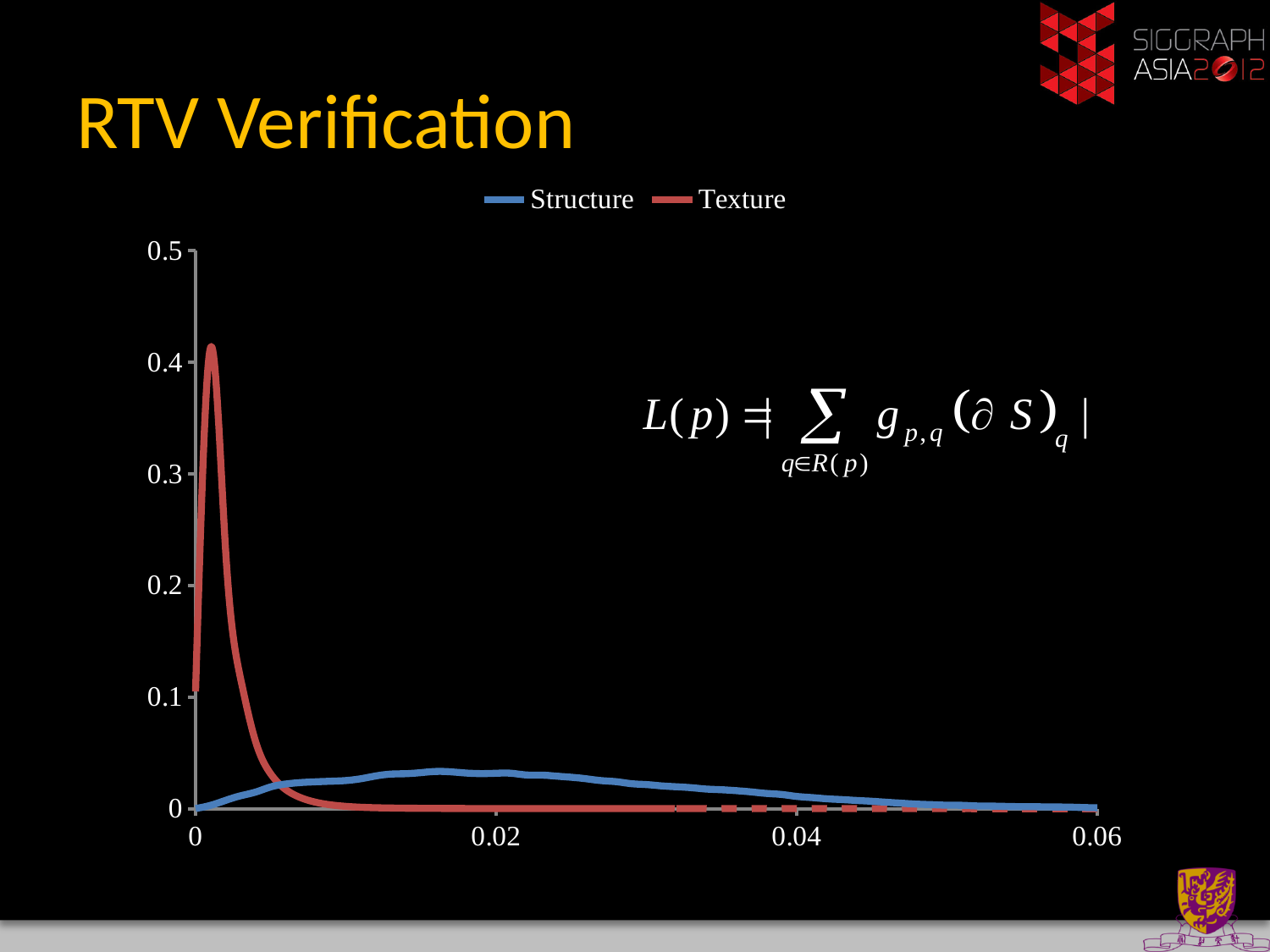
Does the Structure line rise or fall between x = 0.04 and x = 0.06? fall Which series reaches the higher peak value, Structure or Texture? Texture What are the two series named in the legend? Structure and Texture Is the peak value of the Structure line greater or less than 0.1? less Which series has the larger value at x = 0.04, Structure or Texture? Structure Is the peak value of the Texture line greater or less than 0.3? greater How many series does the legend list? 2 Is the value of the Texture line at x = 0.02 greater or less than 0.1? less What kind of chart is shown on the slide? line chart After its peak near x = 0, does the Texture line rise or fall as x increases? fall What colour is the Texture line? red